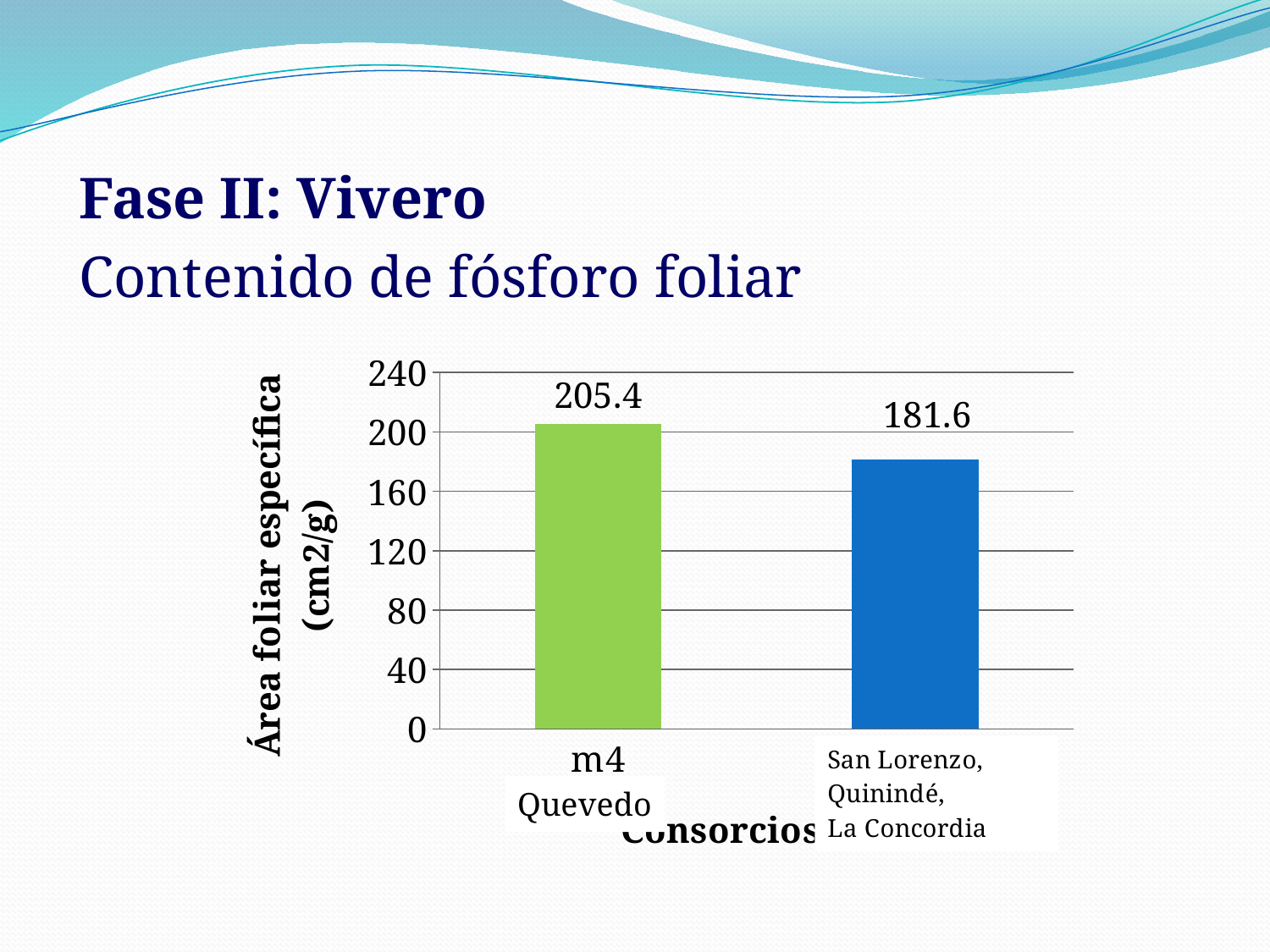
Which is larger, the value for m4 Quevedo or the value for San Lorenzo, Quinindé, La Concordia? m4 Quevedo Which category has the highest value? m4 Quevedo Which category has the lowest value? San Lorenzo, Quinindé, La Concordia Is the value for m4 Quevedo greater or less than 200? greater What is the label of the vertical axis? Área foliar específica (cm2/g) What is the difference between the values for m4 Quevedo and San Lorenzo, Quinindé, La Concordia? 23.8 Is the value for San Lorenzo, Quinindé, La Concordia greater or less than 200? less What is the value for m4 Quevedo? 205.4 What is the value for San Lorenzo, Quinindé, La Concordia? 181.6 What colour is the bar for m4 Quevedo? green How many categories are shown in the chart? 2 What kind of chart is shown on the slide? bar chart